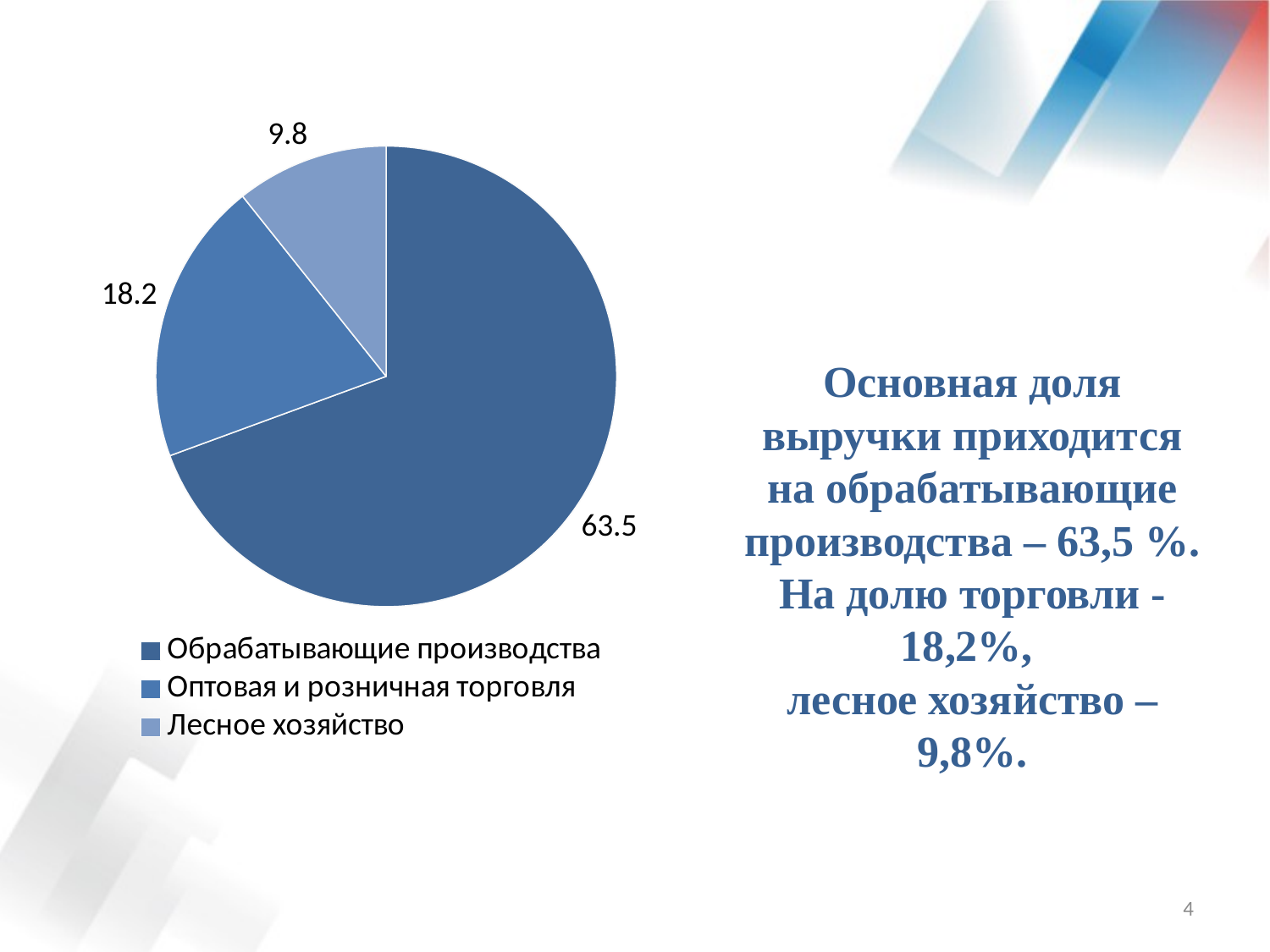
What is the difference between the values for Обрабатывающие производства and Оптовая и розничная торговля? 45.3 How many slices does the pie chart have? 3 Which category has the smallest slice in the pie chart? Лесное хозяйство What value is shown for Обрабатывающие производства in the pie chart? 63.5 What kind of chart is shown on the slide? Pie chart What is the difference between the values for Оптовая и розничная торговля and Лесное хозяйство? 8.4 What value is shown for Лесное хозяйство in the pie chart? 9.8 How many entries does the legend of the pie chart list? 3 Which category has the largest slice in the pie chart? Обрабатывающие производства Which is larger, the value for Оптовая и розничная торговля or the value for Лесное хозяйство? Оптовая и розничная торговля What value is shown for Оптовая и розничная торговля in the pie chart? 18.2 Which legend entry is shown with the lightest blue colour? Лесное хозяйство